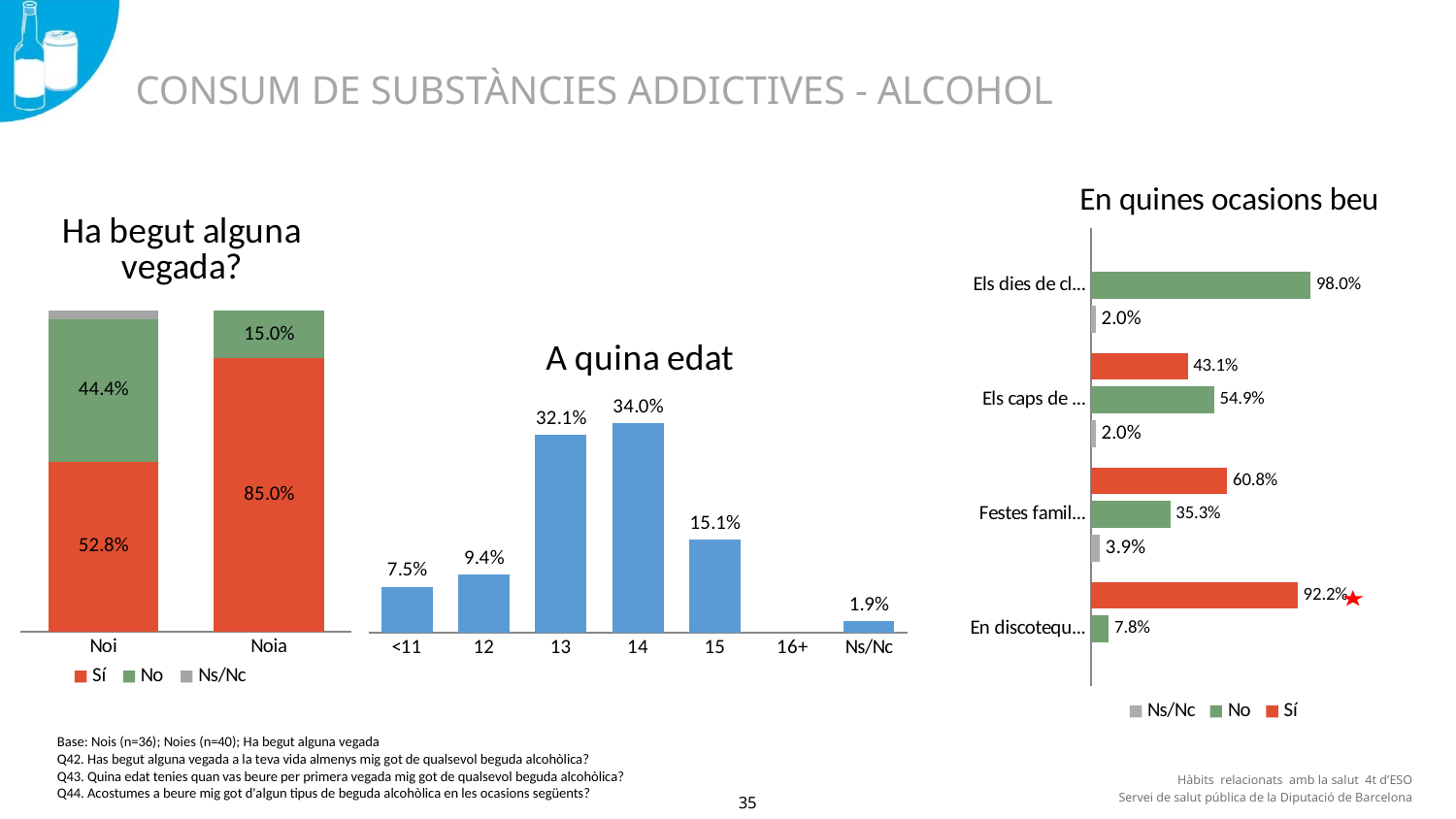
What kind of chart is 'A quina edat'? Bar chart In the 'En quines ocasions beu' chart, how many series does the legend list? 3 In the 'En quines ocasions beu' chart, what is the highest value shown for the Sí series? 92.2% In the 'Ha begut alguna vegada?' chart, what percentage of Noia answered Sí? 85.0% In the 'A quina edat' chart, which age category has the highest value? 14 In the 'Ha begut alguna vegada?' chart, how many percentage points higher is the Sí value for Noia than for Noi? 32.2% In the 'A quina edat' chart, how many categories are shown on the x axis? 7 In the 'A quina edat' chart, what is the value for age 13? 32.1% In the 'Ha begut alguna vegada?' chart, how many series does the legend list? 3 In the 'Ha begut alguna vegada?' chart, what percentage of Noi answered No? 44.4% In the 'A quina edat' chart, which has the larger value, age 12 or age 15? 15 In the 'A quina edat' chart, what is the difference between the values for age 14 and age 13? 1.9%